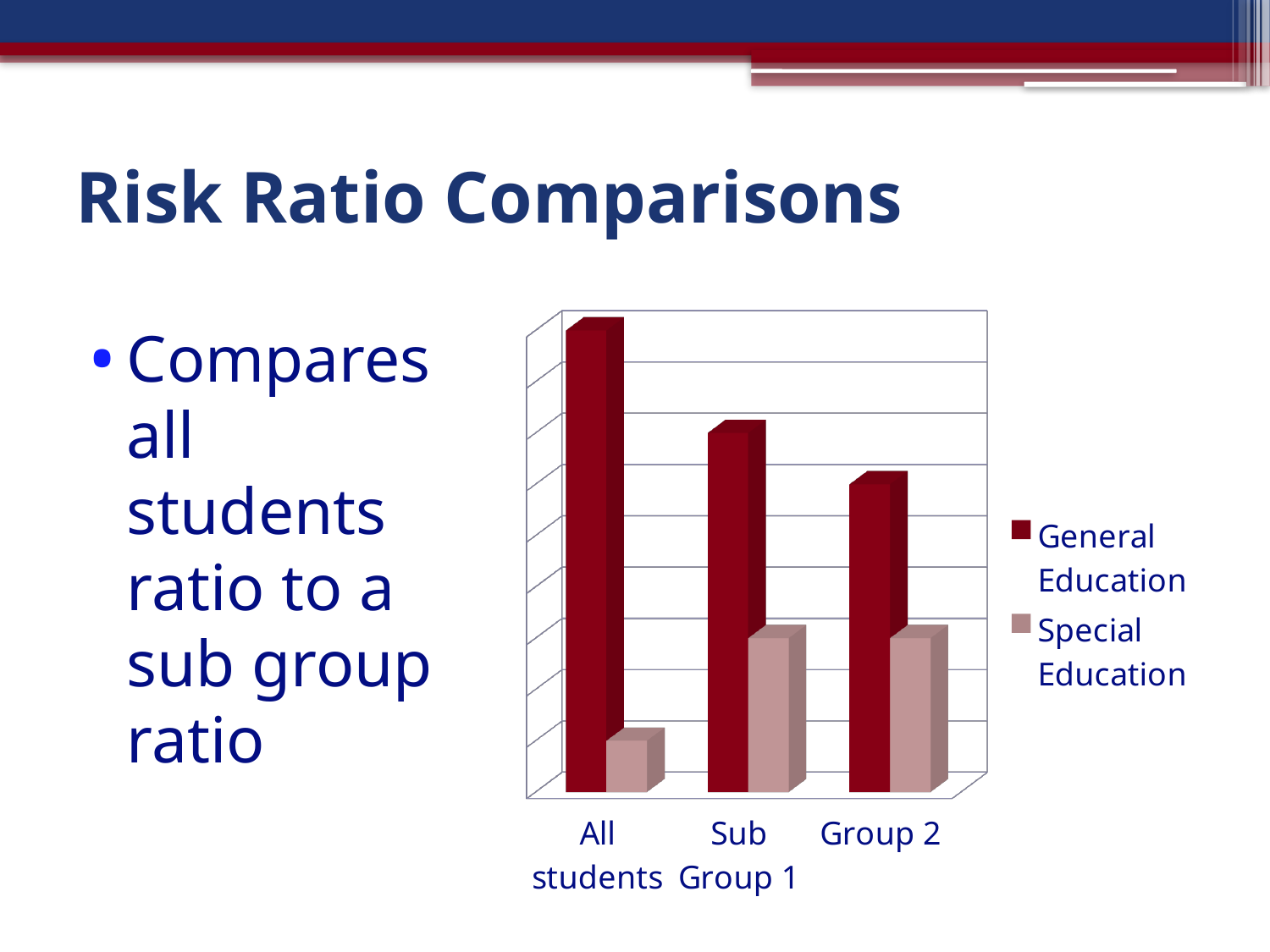
What are the two series named in the chart's legend? General Education and Special Education Which category has the highest General Education bar? All students For All students, which is larger: General Education or Special Education? General Education Do the General Education values rise or fall from All students to Group 2? fall Which category has the lowest Special Education bar? All students For Sub Group 1, which is larger: General Education or Special Education? General Education What kind of chart is shown on the slide? bar chart How many categories are shown on the x axis of the chart? 3 For Group 2, which is larger: General Education or Special Education? General Education Which series is drawn in dark red in the chart? General Education How many series does the chart's legend list? 2 Which category has the lowest General Education bar? Group 2